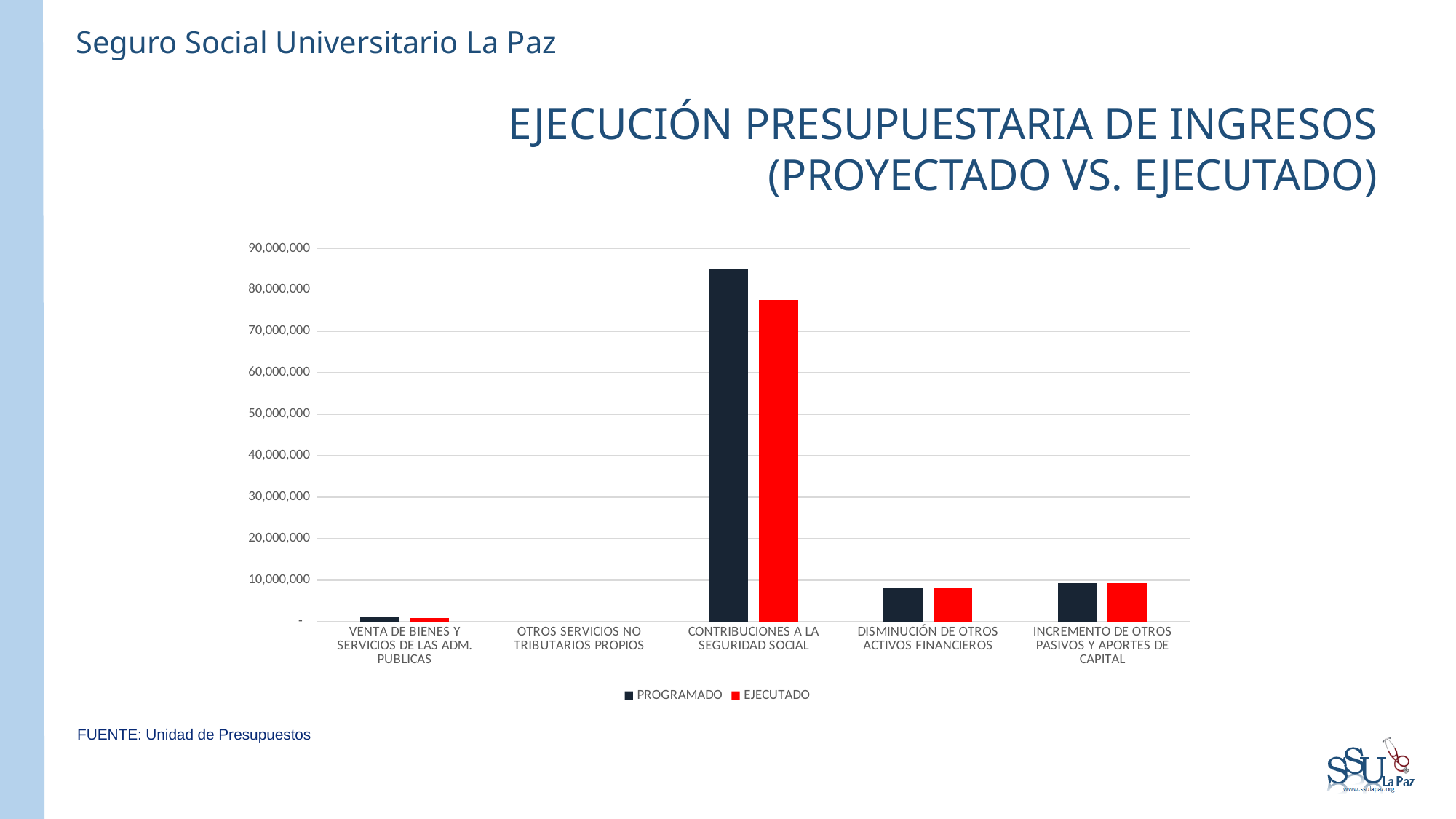
What colour represents the EJECUTADO series? red Is the PROGRAMADO value for INCREMENTO DE OTROS PASIVOS Y APORTES DE CAPITAL greater or less than 10,000,000? less For CONTRIBUCIONES A LA SEGURIDAD SOCIAL, which is larger, PROGRAMADO or EJECUTADO? PROGRAMADO What is the title of the chart? EJECUCIÓN PRESUPUESTARIA DE INGRESOS (PROYECTADO VS. EJECUTADO) Which category has the highest PROGRAMADO value? CONTRIBUCIONES A LA SEGURIDAD SOCIAL Which category has the lowest EJECUTADO value? OTROS SERVICIOS NO TRIBUTARIOS PROPIOS How many categories are shown on the x axis? 5 Is the EJECUTADO value for CONTRIBUCIONES A LA SEGURIDAD SOCIAL greater or less than 80,000,000? less What kind of chart is shown on the slide? bar chart Which has the larger PROGRAMADO value, DISMINUCIÓN DE OTROS ACTIVOS FINANCIEROS or INCREMENTO DE OTROS PASIVOS Y APORTES DE CAPITAL? INCREMENTO DE OTROS PASIVOS Y APORTES DE CAPITAL How many series does the legend list? 2 Is the PROGRAMADO value for CONTRIBUCIONES A LA SEGURIDAD SOCIAL greater or less than 80,000,000? greater